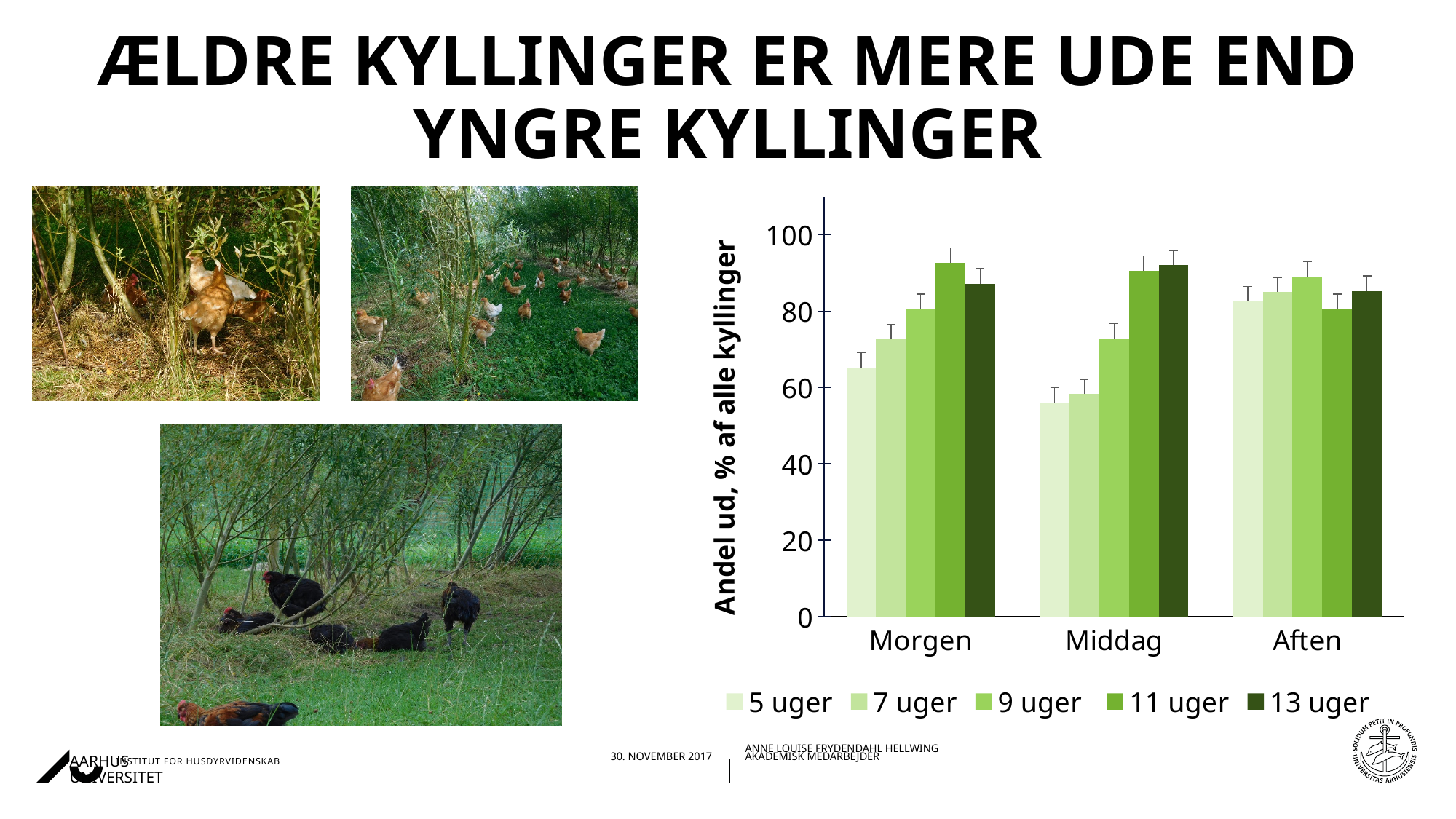
What is the title of the chart's y axis? Andel ud, % af alle kyllinger Within the Morgen group, which series has the lowest value? 5 uger What kind of chart is shown on the slide? bar chart Within the Morgen group, which series has the highest value? 11 uger Is the value for 5 uger at Morgen greater or less than 60? greater Is the value for 9 uger at Aften greater or less than 80? greater Which is larger: the value for 5 uger at Morgen or the value for 5 uger at Middag? 5 uger at Morgen Is the value for 5 uger at Middag greater or less than 60? less How many series does the chart's legend list? 5 Which series is listed first in the chart's legend? 5 uger How many categories are shown on the x axis of the chart? 3